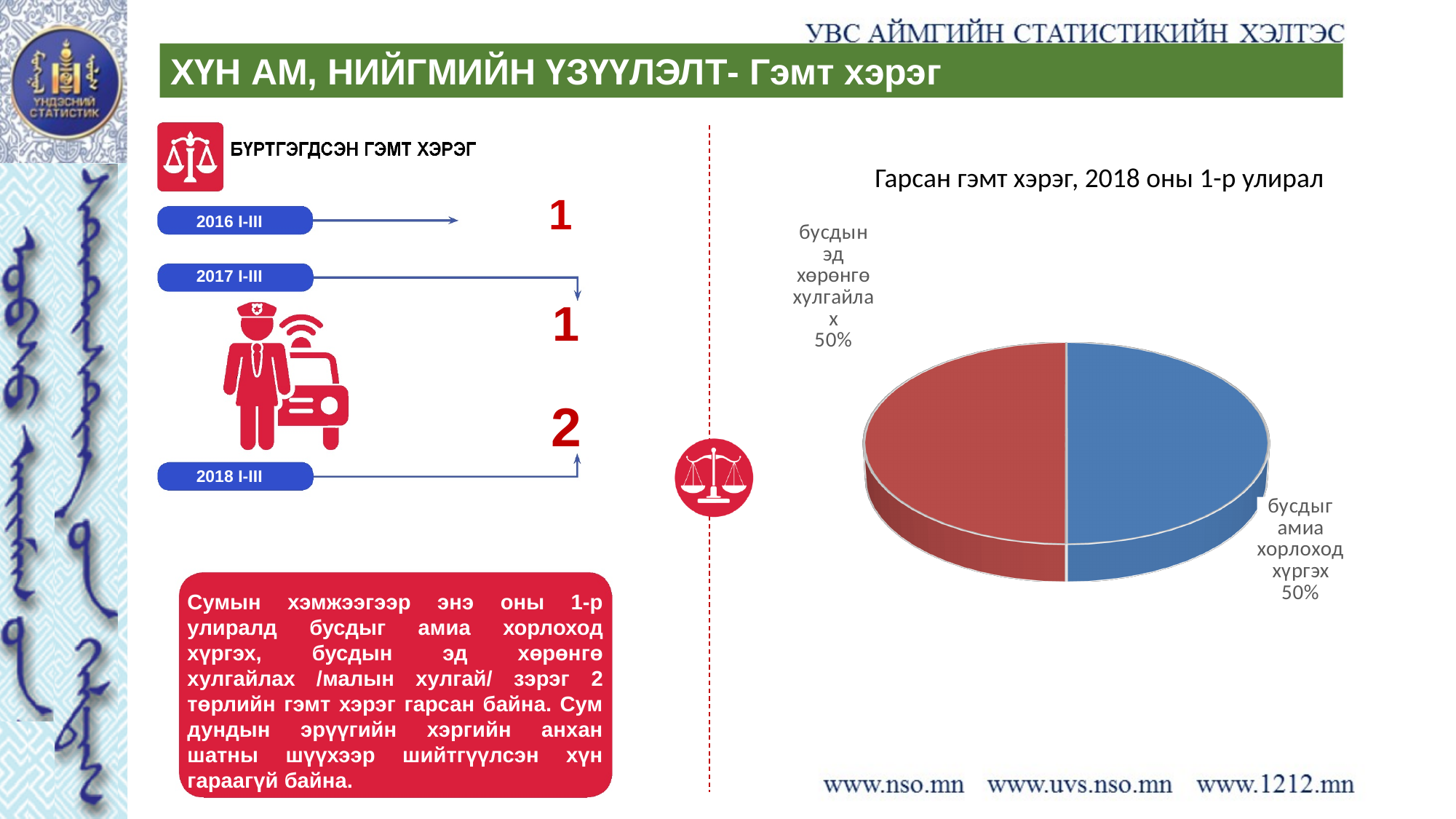
What share of the pie chart is labelled 'бусдыг амиа хорлоход хүргэх'? 50% What share of the pie chart is labelled 'бусдын эд хөрөнгө хулгайлах'? 50% What kind of chart is shown on the right side of the slide? pie chart In the pie chart, is the share for 'бусдыг амиа хорлоход хүргэх' larger, smaller, or equal to the share for 'бусдын эд хөрөнгө хулгайлах'? equal What is the title of the pie chart? Гарсан гэмт хэрэг, 2018 оны 1-р улирал What colour is the 'бусдыг амиа хорлоход хүргэх' slice in the pie chart? blue How many slices does the pie chart have? 2 What is the difference between the two slice shares in the pie chart? 0%